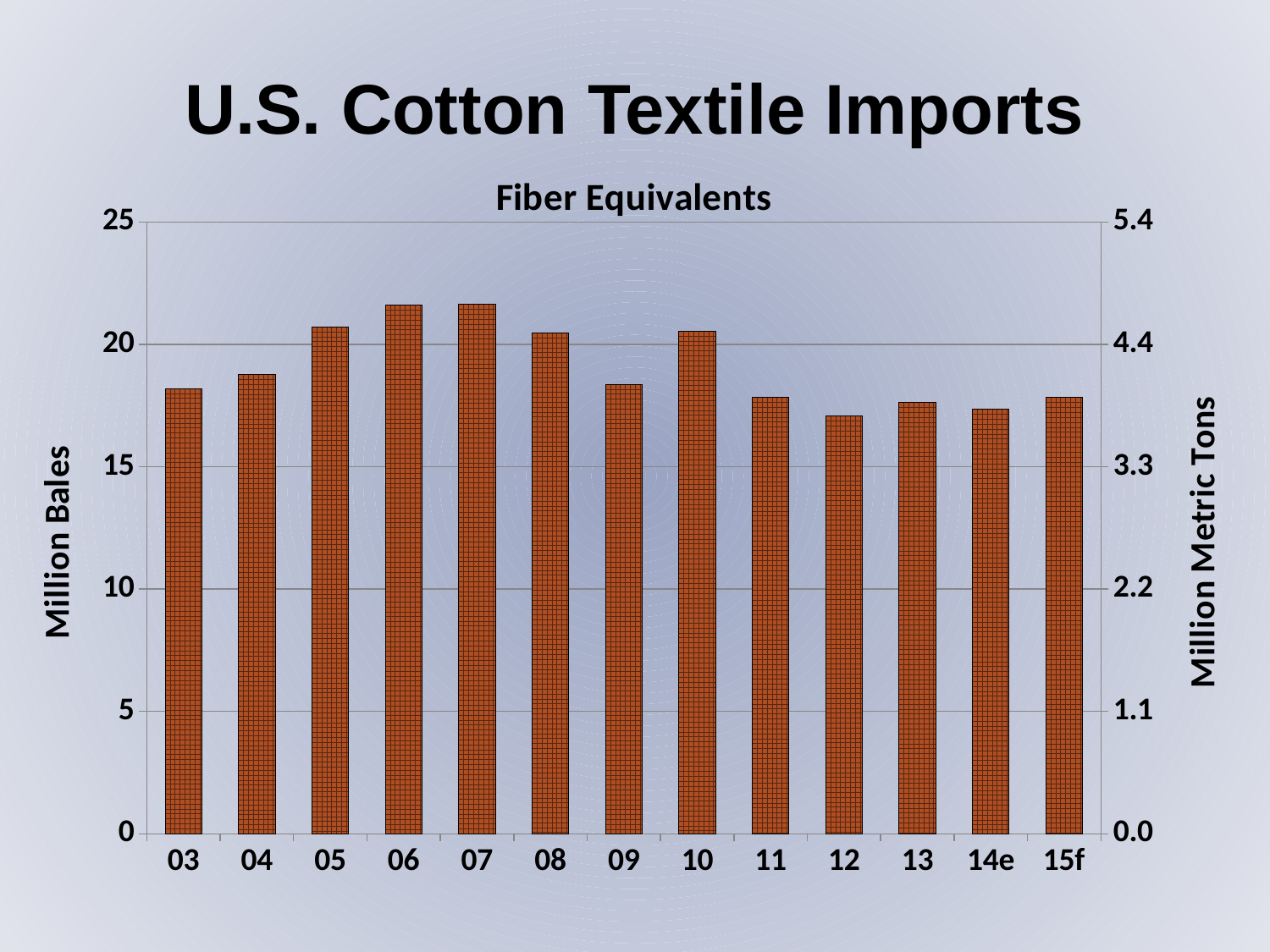
Which is larger, the value for 05 or the value for 04? 05 How many years (categories) are plotted on the x axis? 13 Which is larger, the value for 10 or the value for 11? 10 What is the label of the right vertical axis? Million Metric Tons Is the value for 12 greater or less than 20 million bales? less Which is larger, the value for 06 or the value for 09? 06 Is the value for 09 greater or less than 20 million bales? less What is the label of the left vertical axis? Million Bales Is the value for 03 greater or less than 15 million bales? greater What kind of chart is shown on the slide? bar chart Do the values rise or fall from 03 to 07? rise